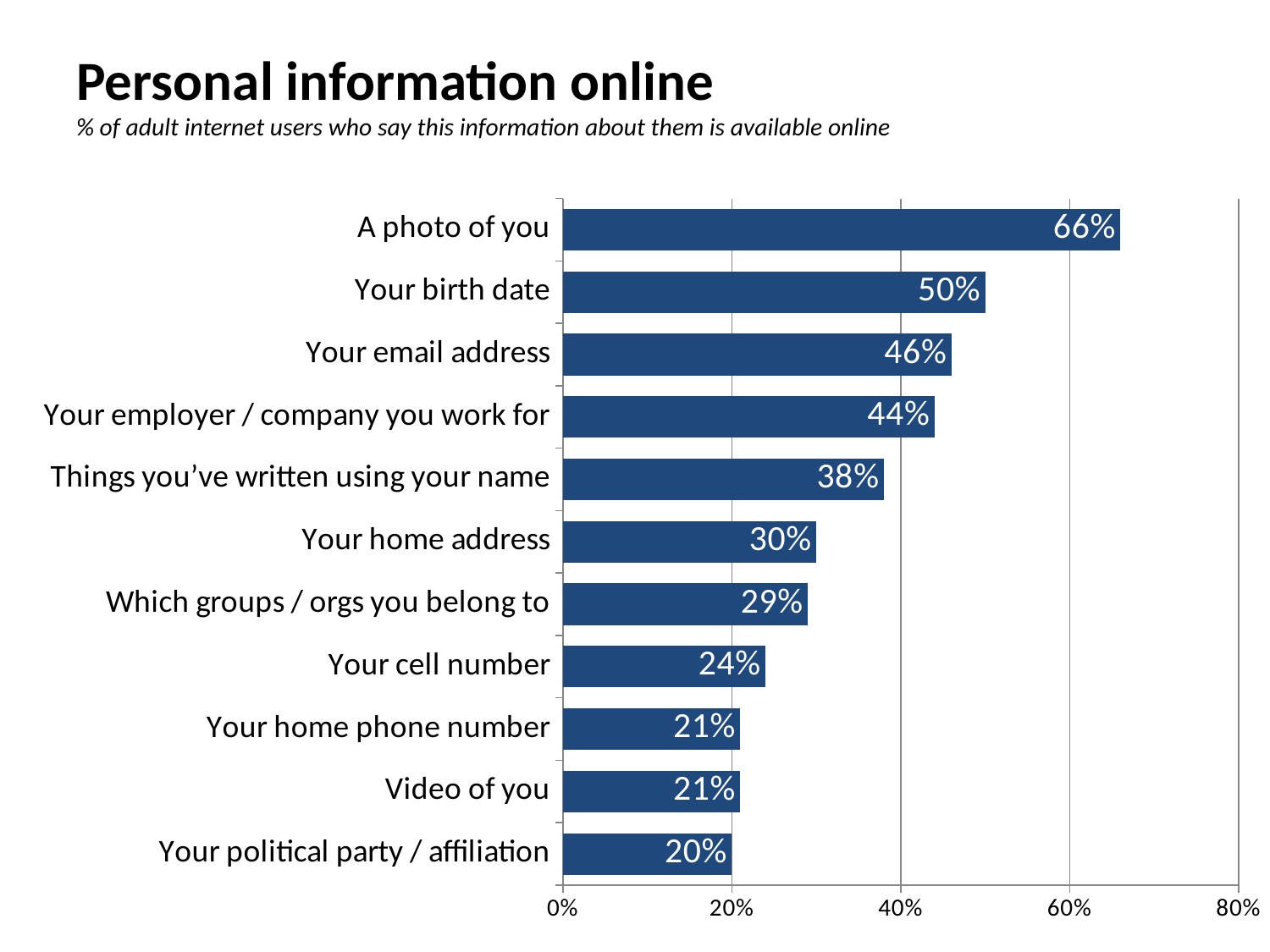
Which category has the lowest value? Your political party / affiliation Is the value for "Which groups / orgs you belong to" greater or less than 40%? less What is the value for "Your home address"? 30% What percentage of adult internet users say a photo of them is available online? 66% What is the difference between "A photo of you" and "Video of you"? 45% What is the title of the chart? Personal information online Which category has the highest value? A photo of you What is the value for "Your cell number"? 24% How many categories are shown in the chart? 11 Which is larger, the value for "Your employer / company you work for" or "Things you've written using your name"? Your employer / company you work for What kind of chart is shown on the slide? Bar chart What is the difference between the values for "Your birth date" and "Your email address"? 4%